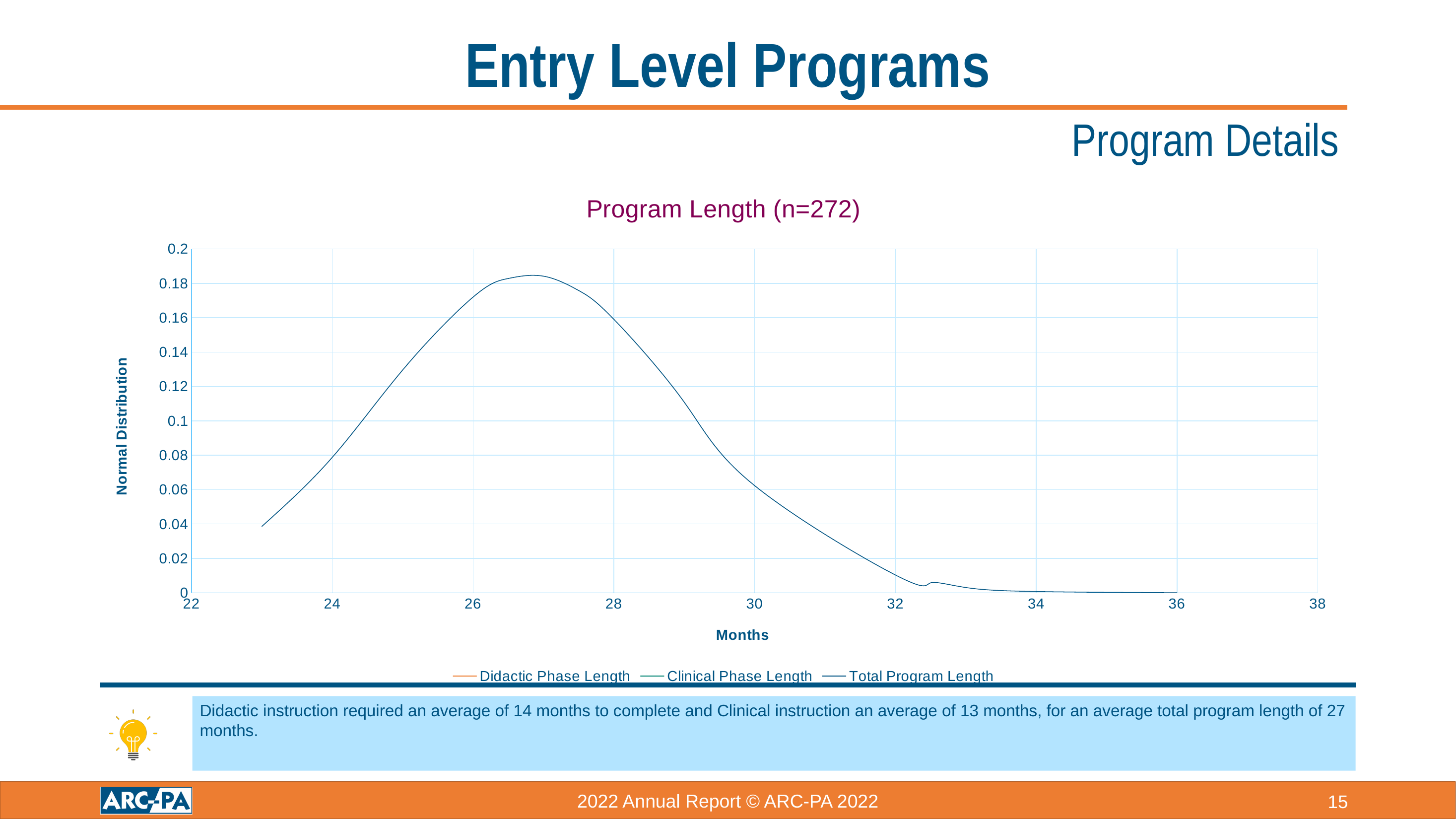
Which has the larger value on the curve, 26 months or 30 months? 26 months What is the label of the x axis? Months Is the value of the curve at 26 months greater or less than 0.16? greater Between 28 and 32 months, does the curve rise or fall? fall What kind of chart is shown on the slide? Line chart Is the value of the curve at 34 months greater or less than 0.02? less Which has the larger value on the curve, 24 months or 28 months? 28 months How many series does the chart legend list? 3 Is the value of the curve at 28 months greater or less than 0.14? greater Between 23 and 26 months, does the curve rise or fall? rise What is the title of the chart? Program Length (n=272)